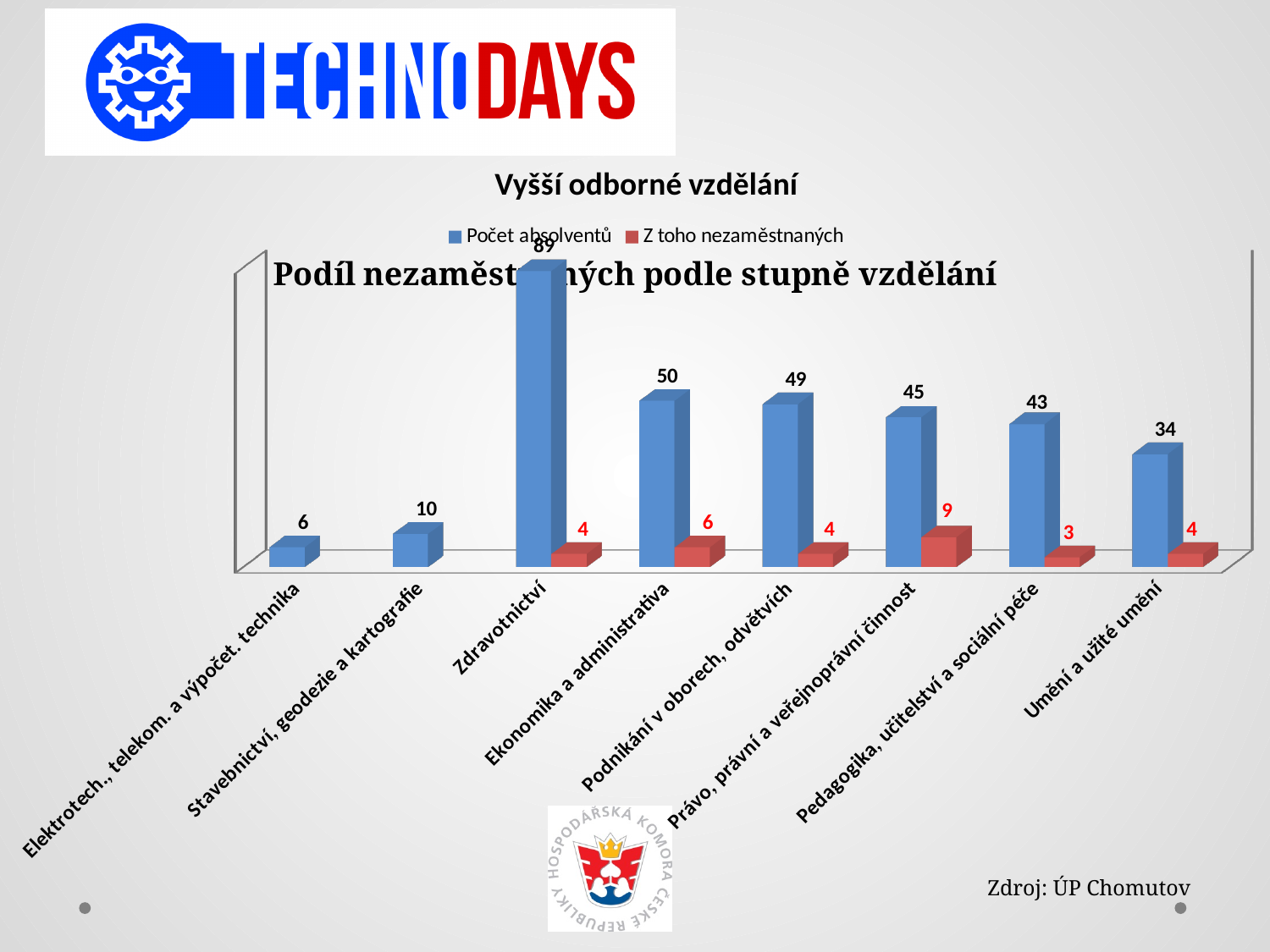
What is the value of Z toho nezaměstnaných for Pedagogika, učitelství a sociální péče? 3 What is the value of Z toho nezaměstnaných for Právo, právní a veřejnoprávní činnost? 9 Which category has the highest value of Z toho nezaměstnaných? Právo, právní a veřejnoprávní činnost What is the difference between Počet absolventů for Zdravotnictví and for Ekonomika a administrativa? 39 What is the value of Počet absolventů for Zdravotnictví? 89 What type of chart is shown? Bar chart What is the value of Počet absolventů for Umění a užité umění? 34 How many categories are shown on the x axis? 8 Which is larger: Počet absolventů for Stavebnictví, geodezie a kartografie or for Umění a užité umění? Umění a užité umění How many series does the legend list? 2 Which category has the lowest value of Počet absolventů? Elektrotech., telekom. a výpočet. technika Which category has the highest value of Počet absolventů? Zdravotnictví